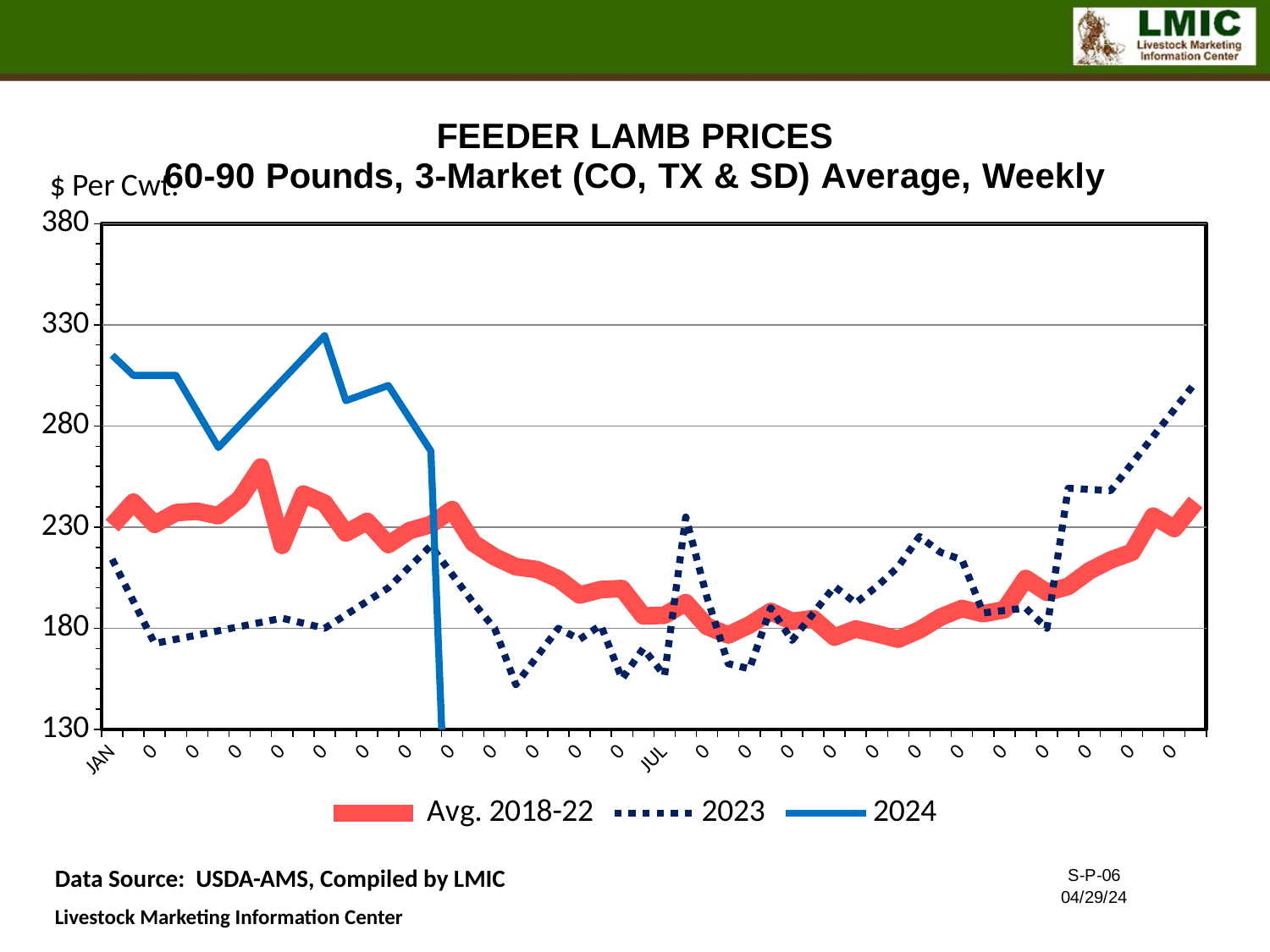
How many series does the legend list? 3 Does the 2023 line rise or fall over the last weeks of the year shown on the chart? rise Is the highest 2023 value on the chart greater or less than 280? greater What is the title of the chart? FEEDER LAMB PRICES 60-90 Pounds, 3-Market (CO, TX & SD) Average, Weekly Which series has the highest value in January? 2024 What are the three series listed in the legend? Avg. 2018-22, 2023, 2024 What kind of chart is shown on the slide? line chart In January, which series has the higher value: 2024 or 2023? 2024 Is the Avg. 2018-22 value in January greater or less than 280? less Is the 2023 value in January greater or less than 230? less